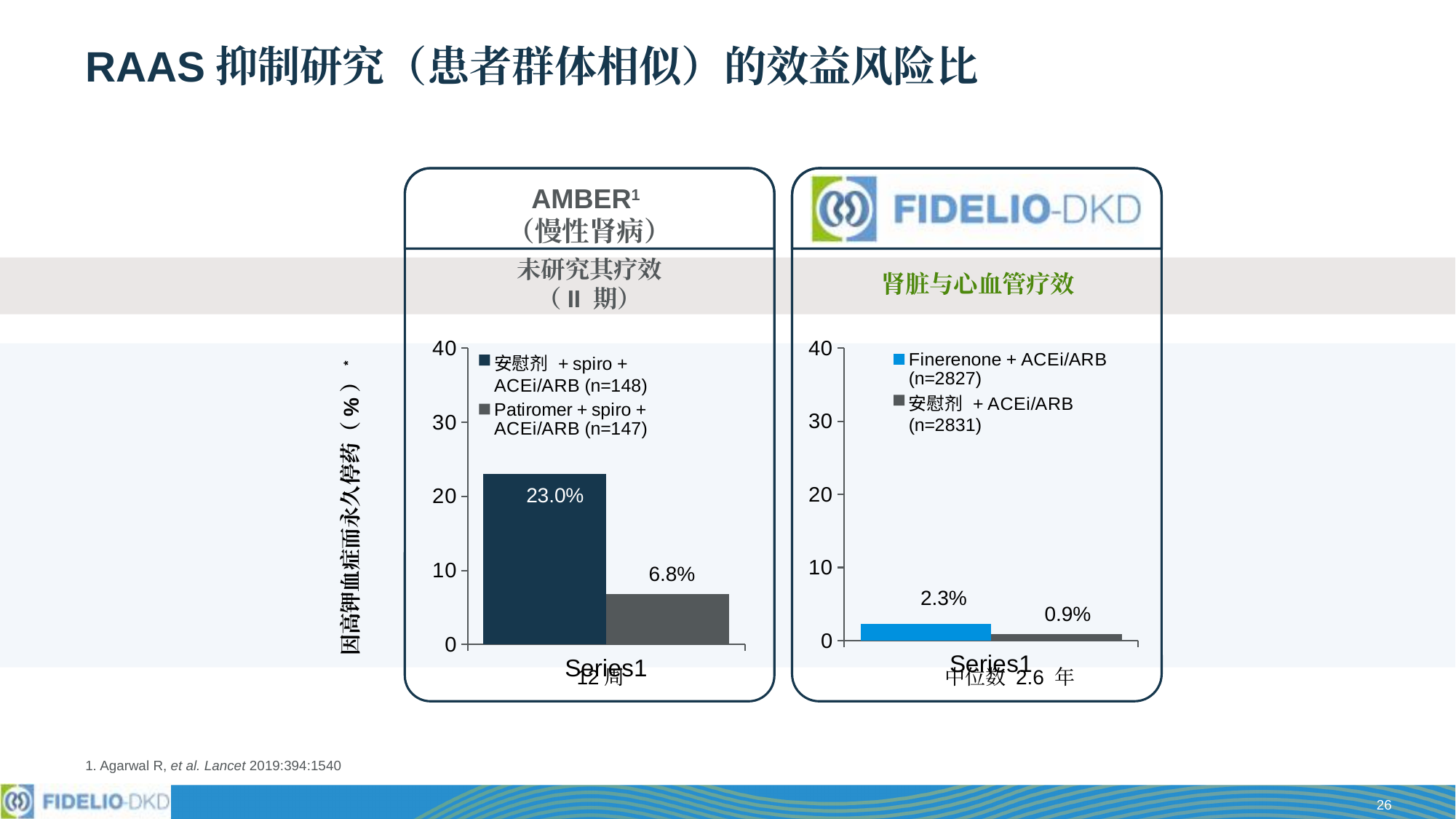
In the AMBER chart on the left, what is the value for Patiromer + spiro + ACEi/ARB (n=147)? 6.8% In the FIDELIO-DKD chart on the right, what is the difference between the Finerenone + ACEi/ARB bar and the 安慰剂 + ACEi/ARB bar? 1.4% In the FIDELIO-DKD chart on the right, which series has the lower value? 安慰剂 + ACEi/ARB (n=2831) In the AMBER chart on the left, what is the value for 安慰剂 + spiro + ACEi/ARB (n=148)? 23.0% How many series does the legend of the FIDELIO-DKD chart on the right list? 2 In the FIDELIO-DKD chart on the right, what is the value for Finerenone + ACEi/ARB (n=2827)? 2.3% In the FIDELIO-DKD chart on the right, what is the value for 安慰剂 + ACEi/ARB (n=2831)? 0.9% In the AMBER chart on the left, what is the difference between the 安慰剂 + spiro + ACEi/ARB bar and the Patiromer + spiro + ACEi/ARB bar? 16.2% In the AMBER chart on the left, is the value for 安慰剂 + spiro + ACEi/ARB greater or less than 20? greater What type of chart is the AMBER chart on the left? bar chart In the AMBER chart on the left, which series has the higher value? 安慰剂 + spiro + ACEi/ARB (n=148) In the FIDELIO-DKD chart on the right, what colour is the Finerenone + ACEi/ARB bar? blue